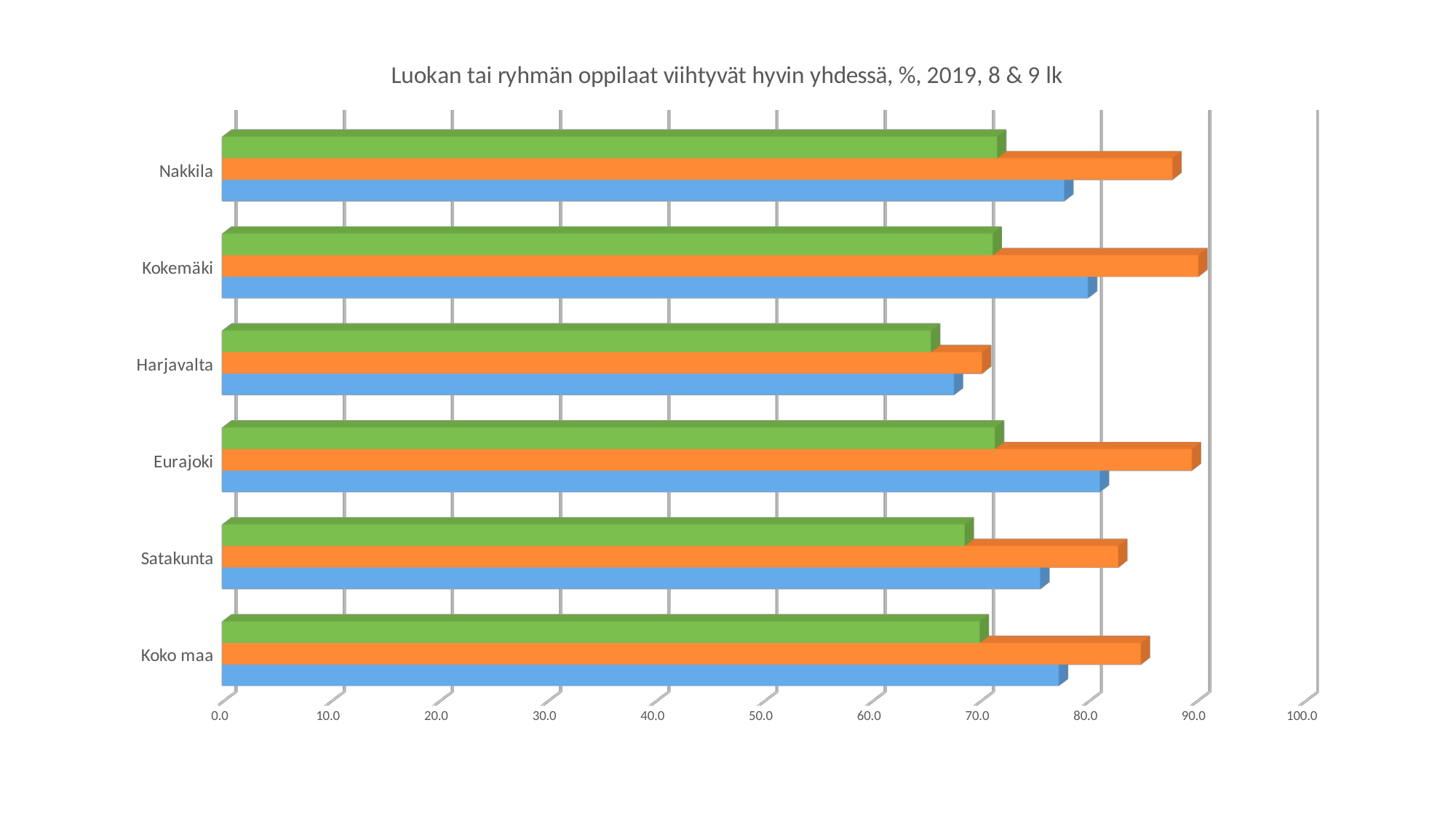
How many categories are shown on the vertical axis of the chart? 6 Is the orange bar for Koko maa greater or less than 80.0? greater Is the orange bar for Nakkila greater or less than 80.0? greater Is the green bar for Harjavalta greater or less than 70.0? less What is the title of the chart? Luokan tai ryhmän oppilaat viihtyvät hyvin yhdessä, %, 2019, 8 & 9 lk What kind of chart is shown on the slide? bar chart Which category has the shortest green bar? Harjavalta Which is larger, the orange bar for Nakkila or the orange bar for Harjavalta? Nakkila Which is larger, the green bar for Eurajoki or the green bar for Harjavalta? Eurajoki How many bars are drawn for each category in the chart? 3 Which category has the shortest orange bar? Harjavalta